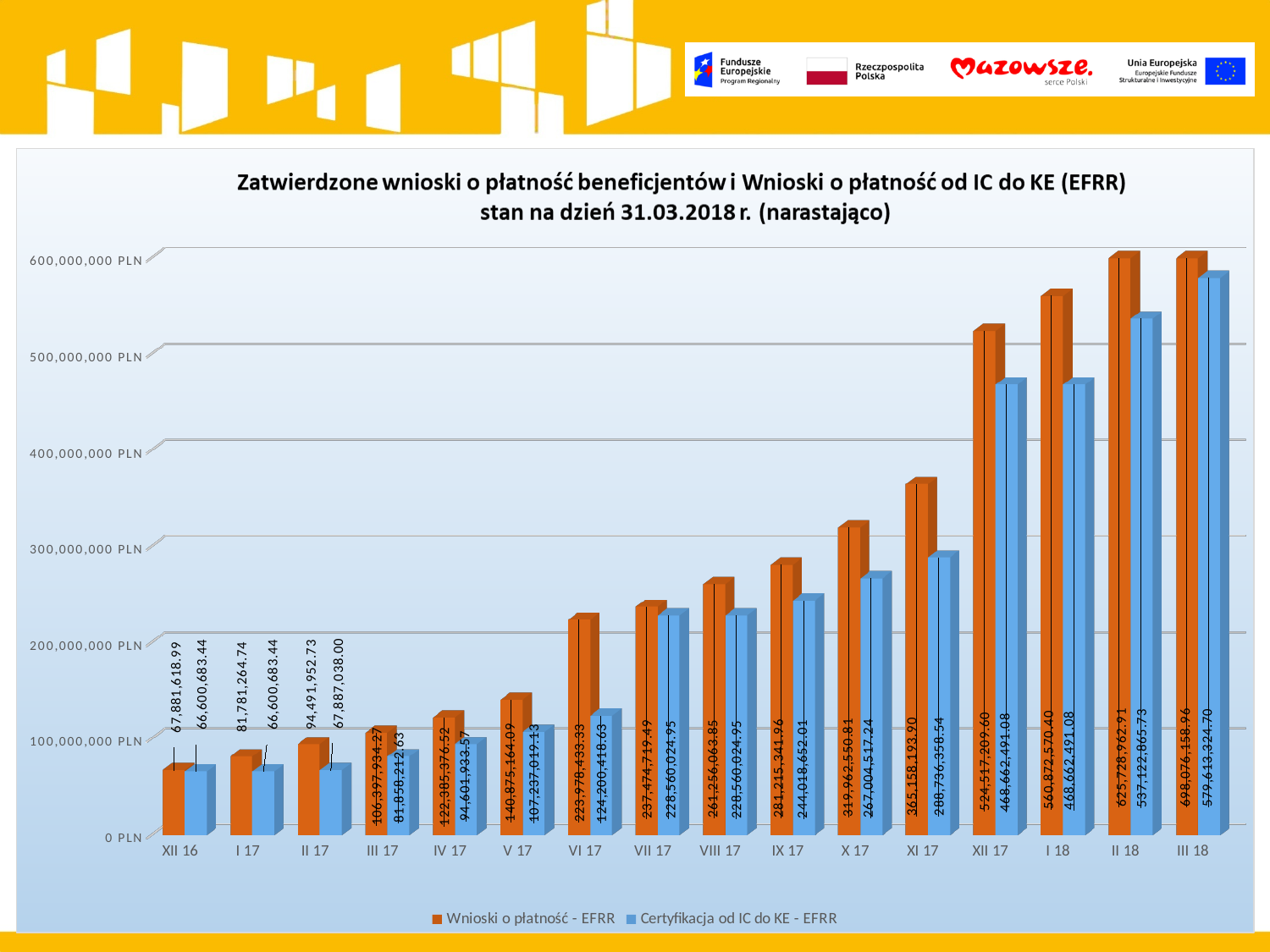
Which period has the lowest value for Wnioski o płatność - EFRR? XII 16 What is the value of Certyfikacja od IC do KE - EFRR for II 18? 537,122,865.73 Do the values of Wnioski o płatność - EFRR rise or fall from XII 16 to III 18? rise Which is larger for X 17: Wnioski o płatność - EFRR or Certyfikacja od IC do KE - EFRR? Wnioski o płatność - EFRR Is the value of Certyfikacja od IC do KE - EFRR for X 17 greater or less than 300,000,000 PLN? less What is the value of Certyfikacja od IC do KE - EFRR for XII 17? 468,662,491.08 How many series does the legend list? 2 How many periods are shown on the x axis? 16 What is the value of Wnioski o płatność - EFRR for III 18? 698,076,158.96 What is the value of Wnioski o płatność - EFRR for VI 17? 223,978,433.33 Which period has the highest value for Wnioski o płatność - EFRR? III 18 What is the difference between Wnioski o płatność - EFRR and Certyfikacja od IC do KE - EFRR for III 18? 118,462,834.26